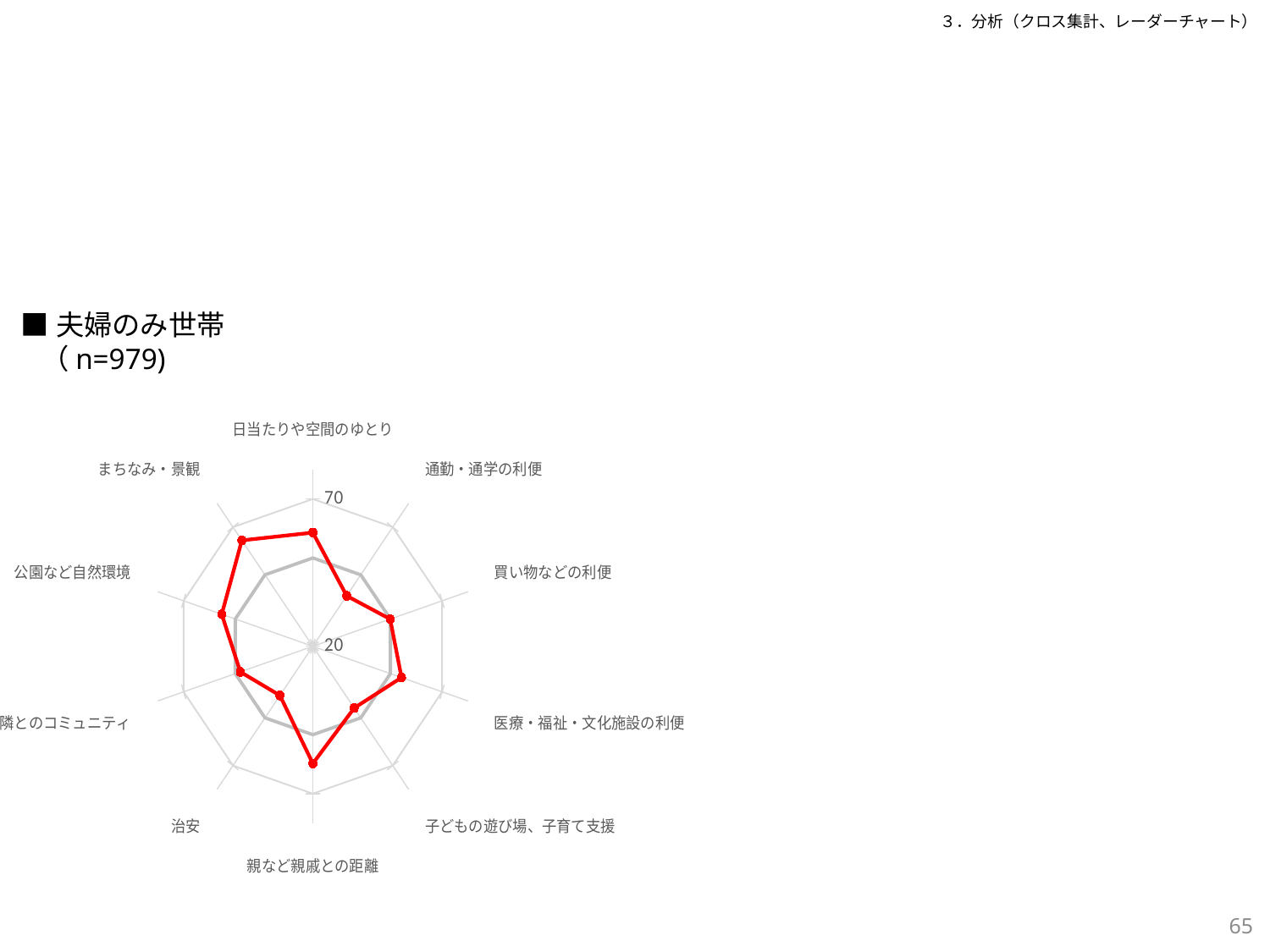
In the red series, which is larger: 日当たりや空間のゆとり or 通勤・通学の利便? 日当たりや空間のゆとり Is the red series value for 日当たりや空間のゆとり greater or less than 70? less What kind of chart is shown on the slide? Radar chart Is the red series value for 親など親戚との距離 greater or less than 70? less In the red series, which is larger: 親など親戚との距離 or 子どもの遊び場、子育て支援? 親など親戚との距離 How many categories (axes) does the radar chart have? 10 What household type is the radar chart about, according to the heading above it? 夫婦のみ世帯 In the red series, which is larger: まちなみ・景観 or 治安? まちなみ・景観 How many data series are plotted on the radar chart? 2 Is the red series value for 通勤・通学の利便 greater or less than 20? greater What is the sample size (n) shown for the chart? n=979